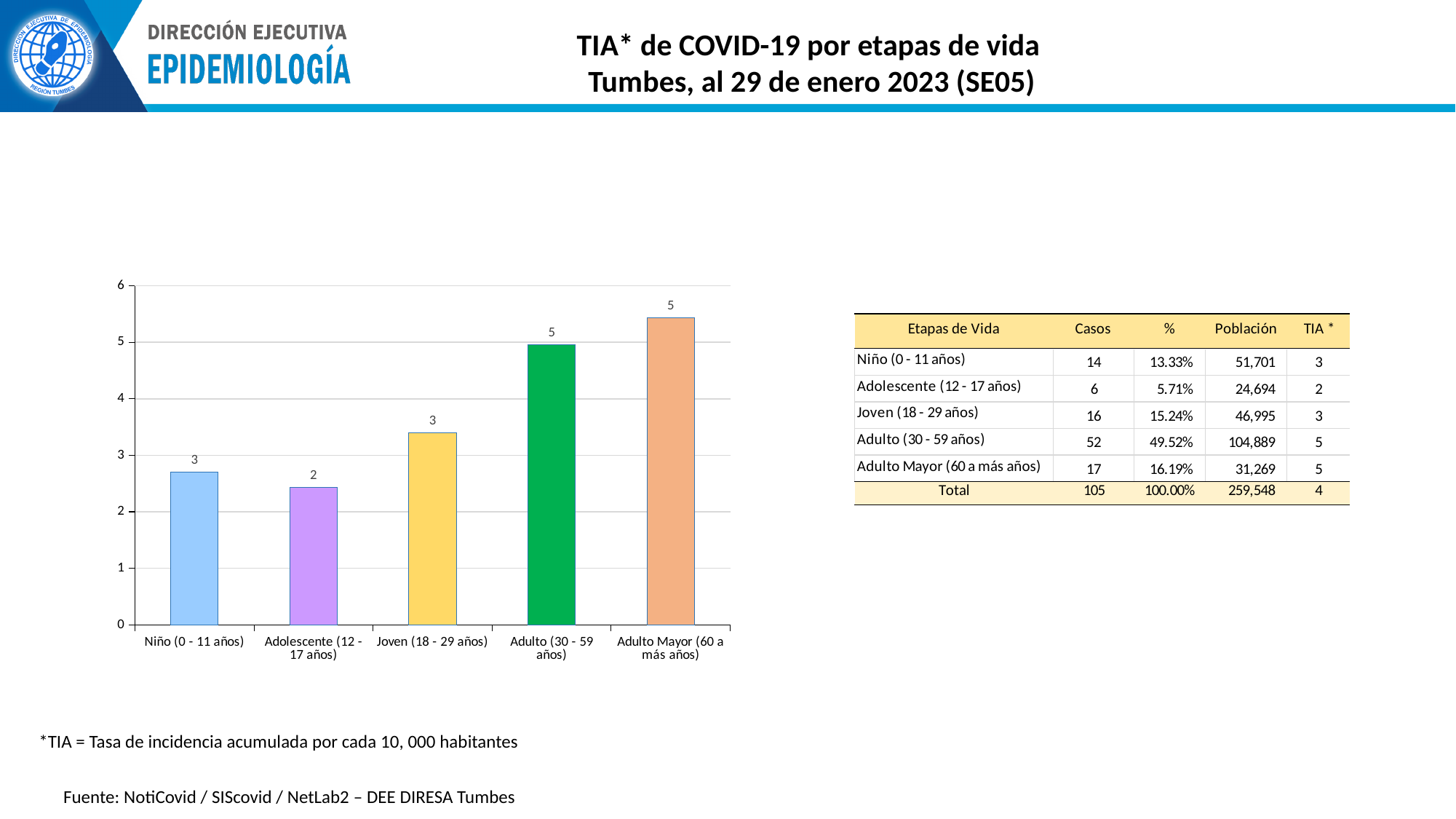
What kind of chart is used on this slide? bar chart Is the value for Adolescente (12 - 17 años) in the bar chart greater or less than 3? less How many life-stage categories are plotted in the bar chart? 5 Which is larger in the bar chart, the value for Adulto (30 - 59 años) or for Adolescente (12 - 17 años)? Adulto (30 - 59 años) What colour is the bar for Adulto (30 - 59 años)? green What is the difference between the labelled values for Adulto (30 - 59 años) and Adolescente (12 - 17 años) in the bar chart? 3 Which life stage has the lowest bar in the chart? Adolescente (12 - 17 años) What is the TIA value shown for Adolescente (12 - 17 años) in the bar chart? 2 What is the TIA value shown for Niño (0 - 11 años) in the bar chart? 3 Which life stage has the tallest bar in the chart? Adulto Mayor (60 a más años) Is the value for Adulto (30 - 59 años) in the bar chart greater or less than 4? greater What is the TIA value shown for Adulto (30 - 59 años) in the bar chart? 5